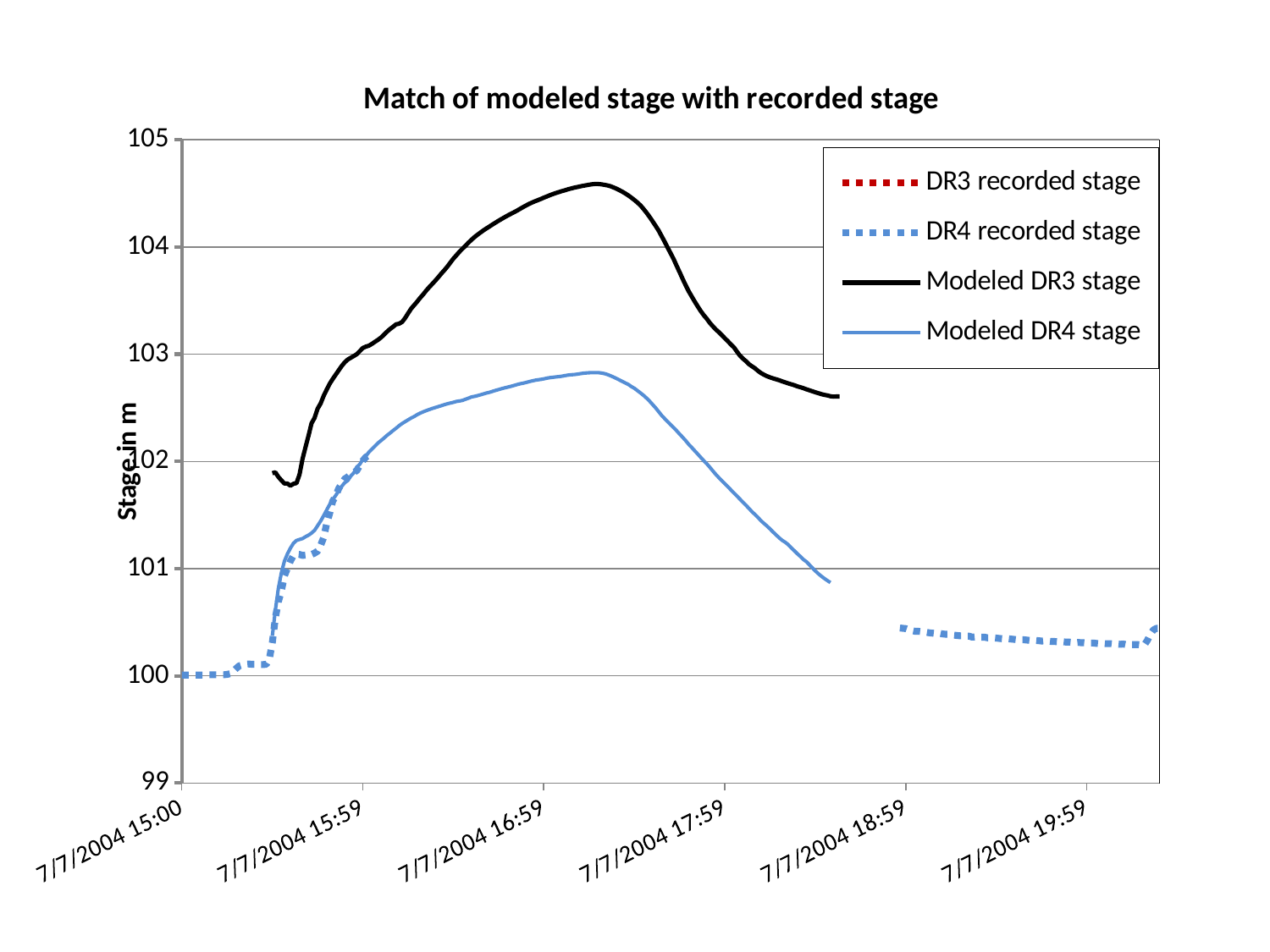
Which is higher at its peak, the Modeled DR3 stage or the Modeled DR4 stage? Modeled DR3 stage Is the peak value of the Modeled DR4 stage greater or less than 103? less How many series does the legend list? 4 Which series reaches the highest stage on the chart? Modeled DR3 stage What kind of chart is shown on the slide? line chart Is the DR4 recorded stage after 7/7/2004 18:59 greater or less than 101? less What is the label of the vertical axis? Stage in m Is the DR4 recorded stage at 7/7/2004 15:00 greater or less than 101? less Does the Modeled DR4 stage rise or fall between 7/7/2004 17:59 and 7/7/2004 18:59? fall What is the title of the chart? Match of modeled stage with recorded stage How many time labels are shown on the horizontal axis? 6